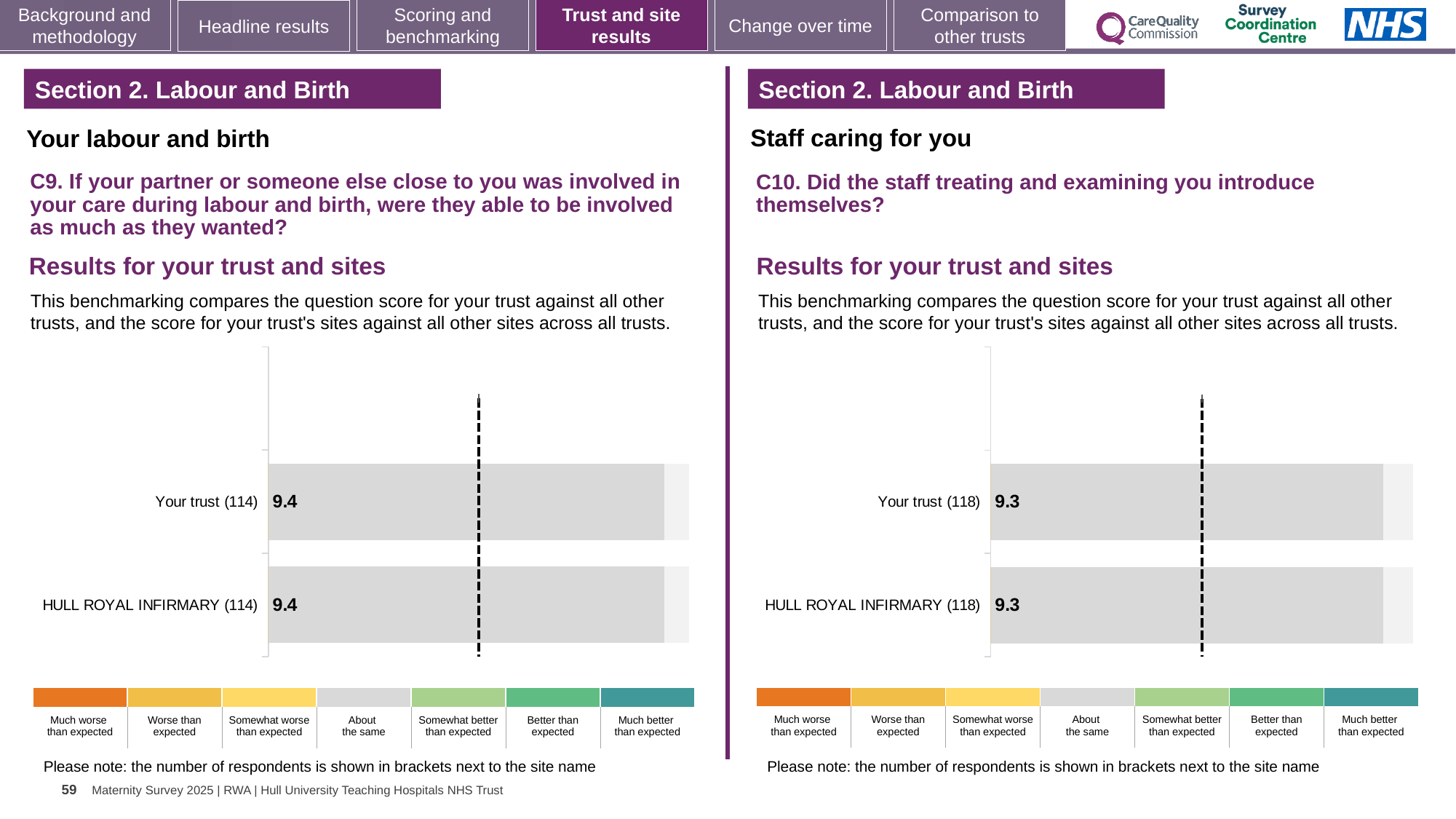
On the right chart (C10), how many bars are plotted? 2 On the left chart (C9), how many bars are plotted? 2 On the left chart (C9), what is the score for Your trust? 9.4 On the right chart (C10), what is the difference between the Your trust score and the HULL ROYAL INFIRMARY score? 0 On the right chart (C10), what is the score for HULL ROYAL INFIRMARY? 9.3 On the right chart (C10), what is the score for Your trust? 9.3 On the left chart (C9), what is the difference between the Your trust score and the HULL ROYAL INFIRMARY score? 0 Is the Your trust score on the left chart (C9) larger or smaller than the Your trust score on the right chart (C10)? Larger What kind of chart is shown on the left (C9)? Bar chart On the left chart (C9), how many respondents are shown in brackets next to Your trust? 114 On the right chart (C10), how many respondents are shown in brackets next to HULL ROYAL INFIRMARY? 118 On the left chart (C9), what is the score for HULL ROYAL INFIRMARY? 9.4